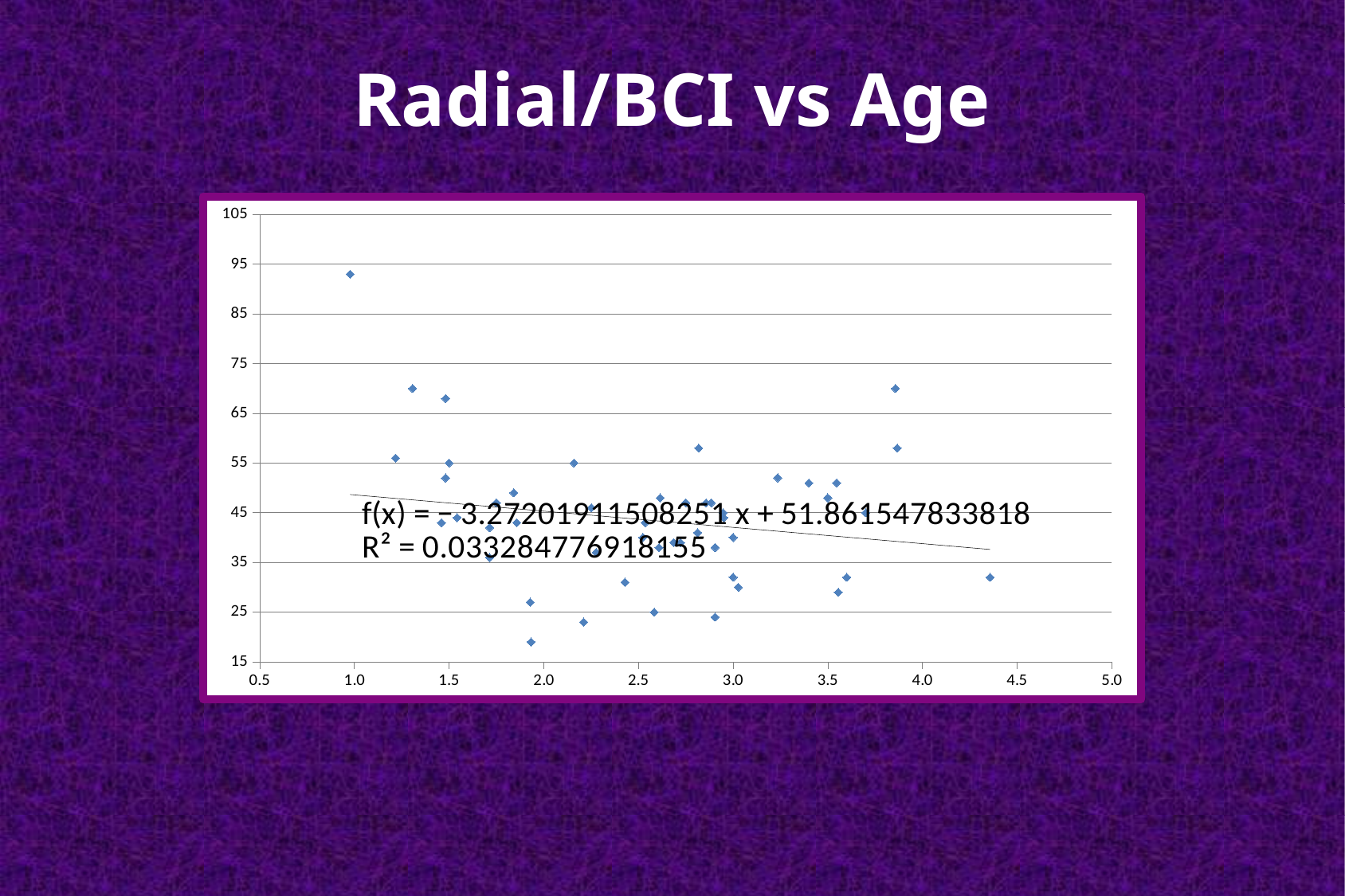
What is the trendline equation printed on the chart? f(x) = -3.27201911508251 x + 51.861547833818 Is the point near Age 1.0 higher or lower than the point near Age 4.35? Higher Is the lowest point on the chart (near Age 1.9) greater or less than 25? less What is the title of the chart on the slide? Radial/BCI vs Age Does the highest point on the chart occur at an Age below 1.5 or above 1.5? Below 1.5 Is the highest point on the chart (near Age 1.0) greater or less than 85? greater What is the slope of the fitted trendline shown on the chart? -3.27201911508251 What kind of chart is shown on the slide? Scatter plot Is the rightmost point on the chart (near Age 4.35) greater or less than 35? less What is the R² value printed on the chart? 0.033284776918155 What is the maximum value shown on the y axis of the chart? 105 According to the trendline, do the Radial/BCI values rise or fall as Age increases? Fall